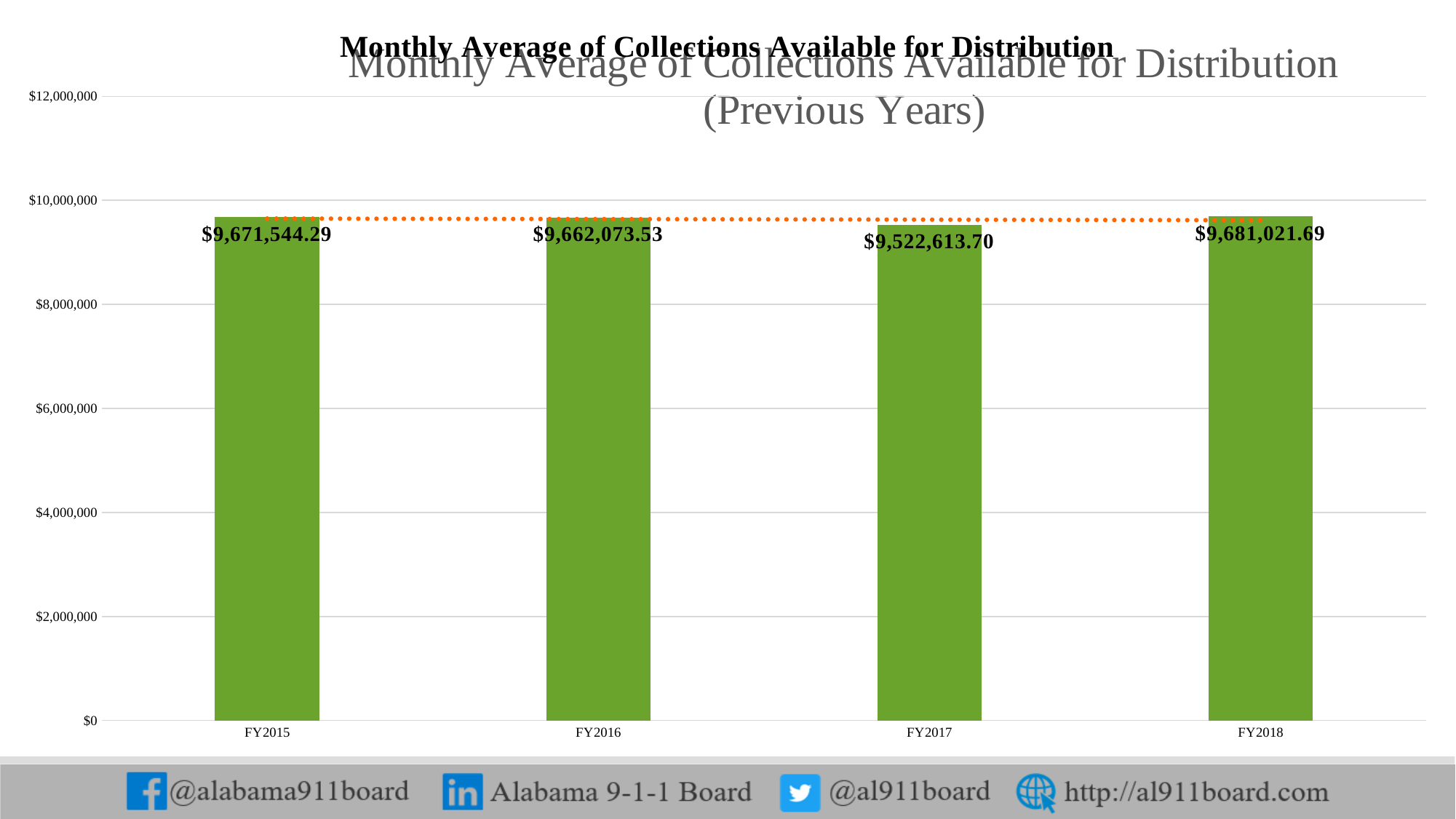
Which is larger, the value for FY2015 or the value for FY2017? FY2015 What colour are the bars in the chart? green What kind of chart is shown on the slide? bar chart What value is shown for FY2017? $9,522,613.70 What is the difference between the FY2018 value and the FY2017 value? $158,407.99 What is the difference between the FY2015 value and the FY2016 value? $9,470.76 Which fiscal year has the highest monthly average of collections available for distribution? FY2018 What is the monthly average of collections available for distribution for FY2015? $9,671,544.29 How many fiscal years are shown on the chart? 4 Is the value for FY2017 greater or less than $10,000,000? less What is the value labeled on the FY2018 bar? $9,681,021.69 Which fiscal year has the lowest monthly average of collections available for distribution? FY2017